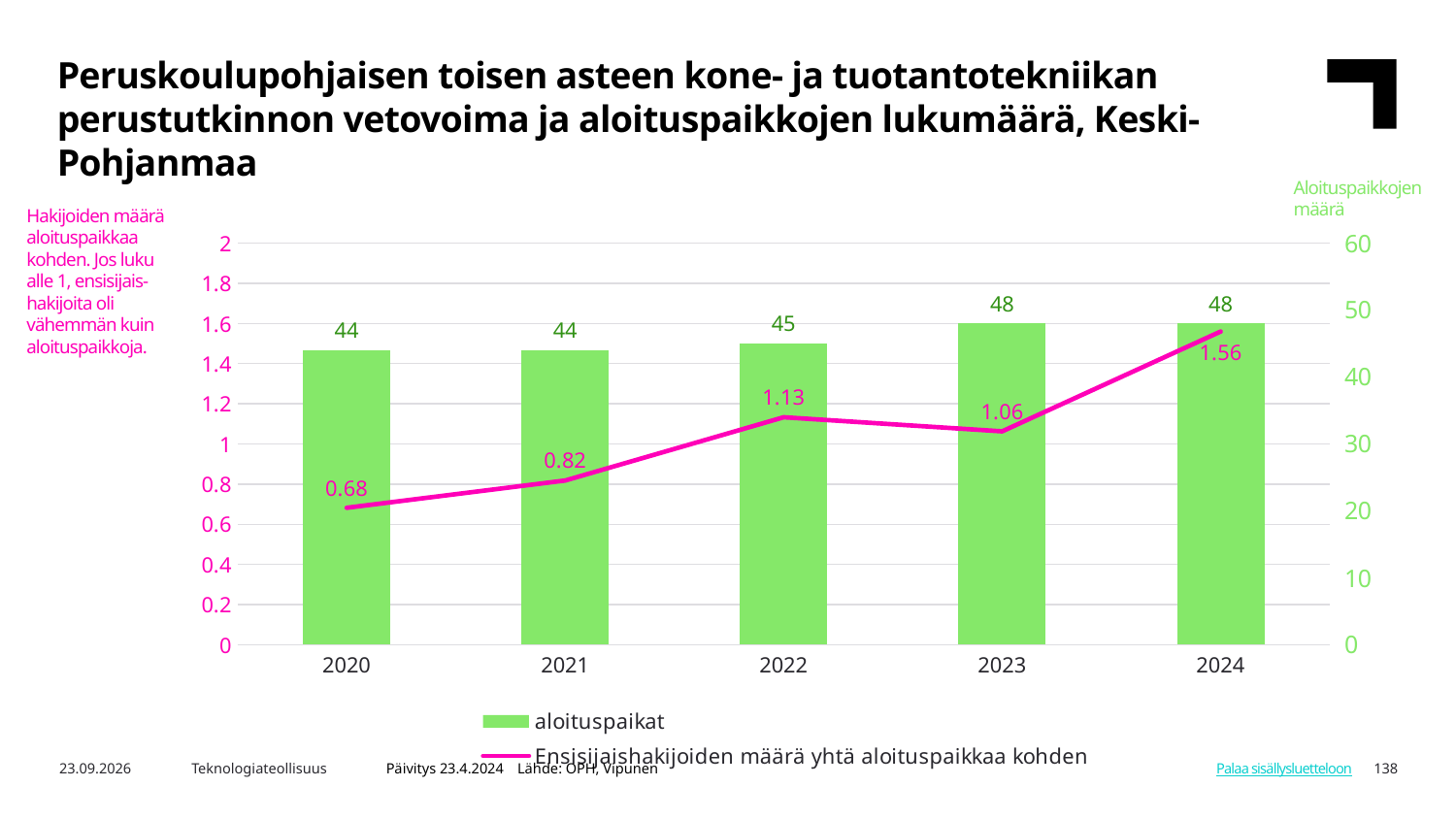
How many years are shown on the x axis? 5 What is the value of Ensisijaishakijoiden määrä yhtä aloituspaikkaa kohden for 2021? 0.82 What is the difference in aloituspaikat between 2024 and 2020? 4 How many series does the legend list? 2 What is the value of aloituspaikat for 2022? 45 What is the value of Ensisijaishakijoiden määrä yhtä aloituspaikkaa kohden for 2024? 1.56 Which year has the highest value for Ensisijaishakijoiden määrä yhtä aloituspaikkaa kohden? 2024 Which is larger, the aloituspaikat value for 2022 or for 2023? 2023 What is the difference in Ensisijaishakijoiden määrä yhtä aloituspaikkaa kohden between 2022 and 2023? 0.07 Does the Ensisijaishakijoiden määrä yhtä aloituspaikkaa kohden line rise or fall from 2020 to 2022? Rise Which year has the lowest value for Ensisijaishakijoiden määrä yhtä aloituspaikkaa kohden? 2020 What kinds of chart are combined on this slide? Bar chart and line chart